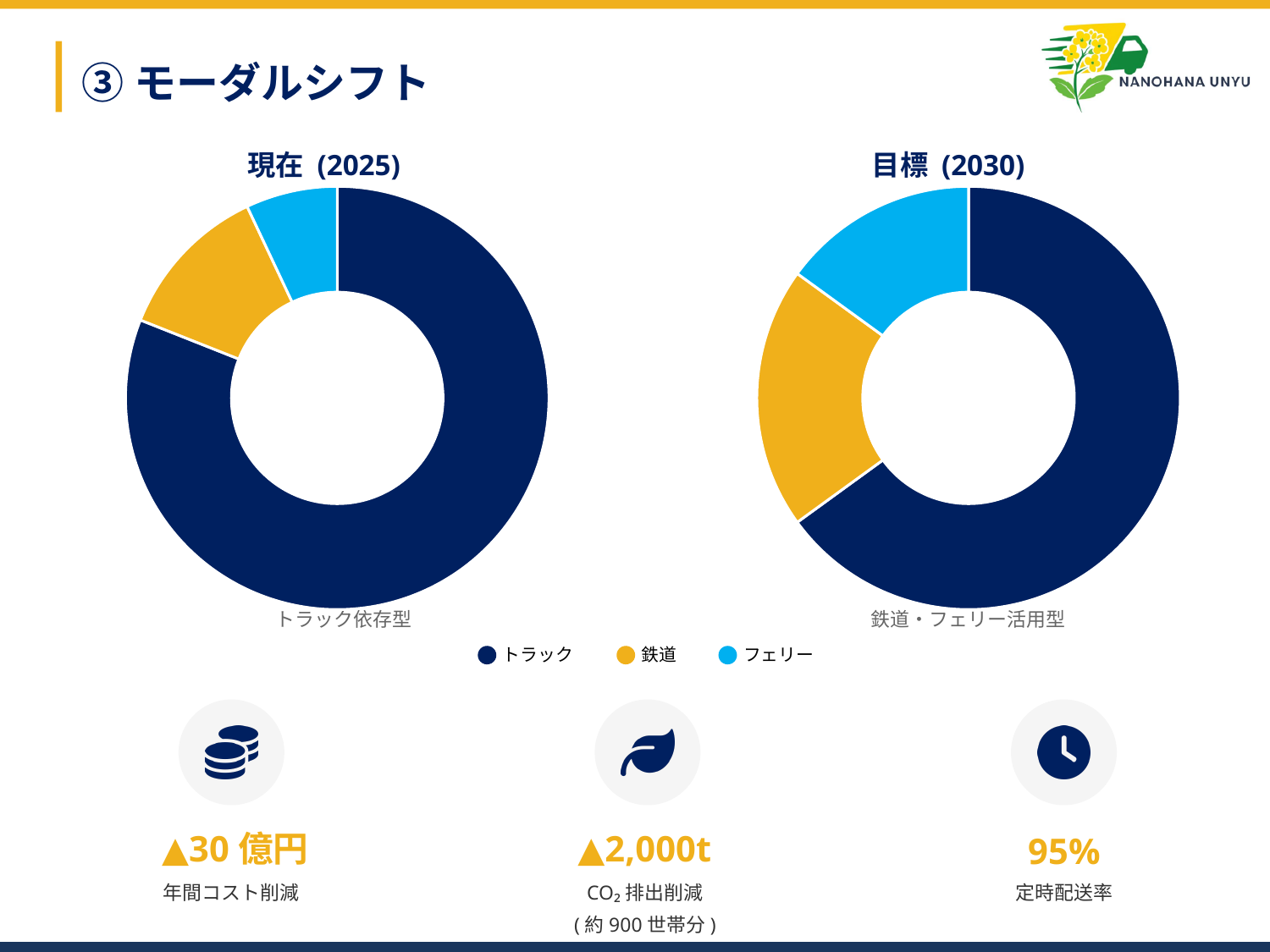
How many slices does the 現在 (2025) chart have? 3 How many charts are shown on the slide? 2 Which colour represents フェリー in the legend? Light blue In the 目標 (2030) chart, which slice is larger, 鉄道 or フェリー? 鉄道 What is the title of the chart on the right? 目標 (2030) In the 現在 (2025) chart, which category has the smallest slice? フェリー What kind of chart is the 目標 (2030) chart? Donut chart How many entries does the shared legend list? 3 In the 現在 (2025) chart, which slice is larger, トラック or 鉄道? トラック In the 現在 (2025) chart, which category has the largest slice? トラック What kind of chart is the 現在 (2025) chart? Donut chart In the 目標 (2030) chart, which category has the largest slice? トラック